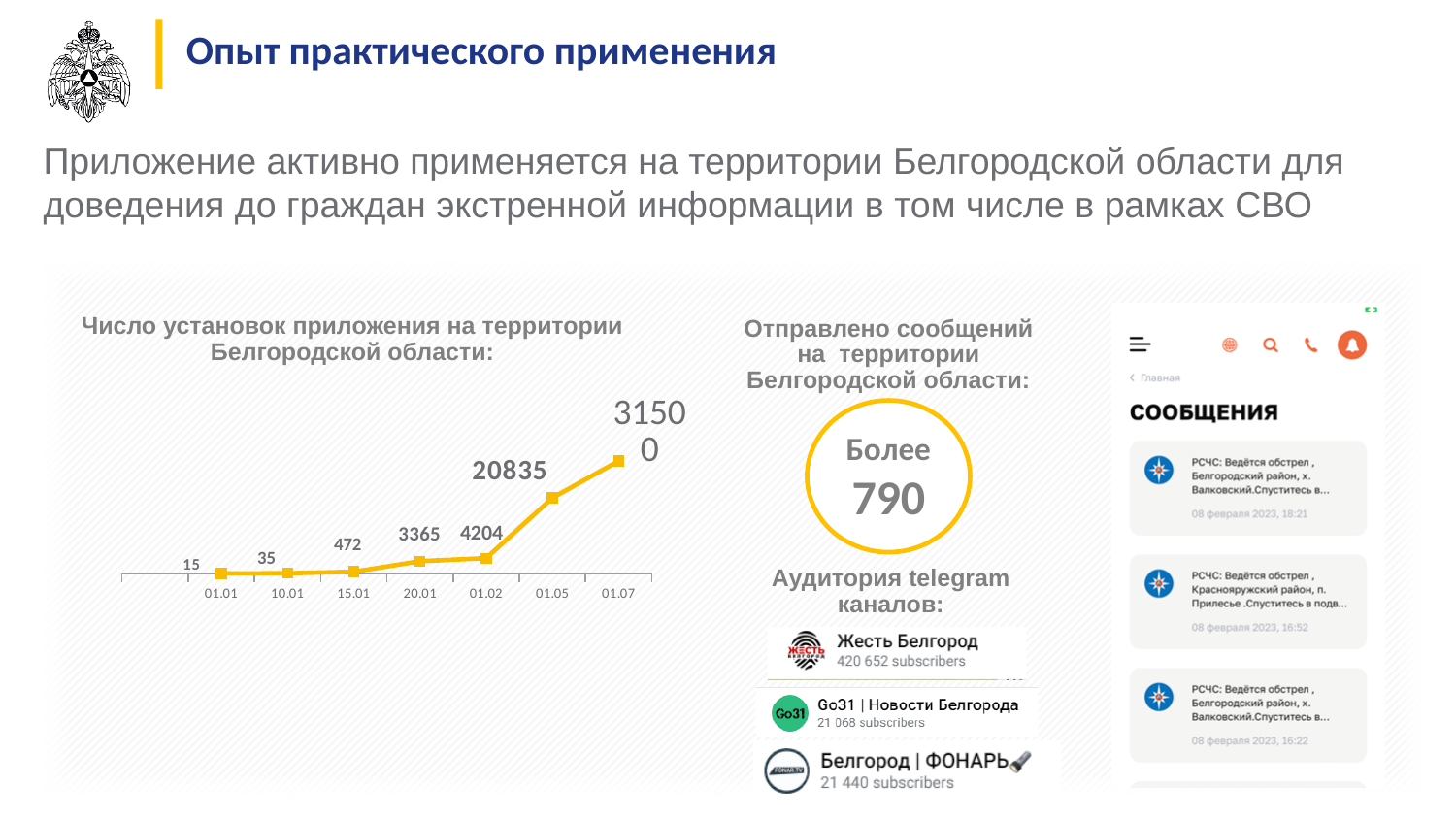
What is the number of app installations on 20.01? 3365 How many data points are plotted on the app installations line chart? 7 Do the values on the app installations line chart rise or fall from left to right? rise What is the title of the line chart on the slide? Число установок приложения на территории Белгородской области What is the number of app installations on 15.01? 472 What is the difference in app installations between 01.02 and 20.01? 839 What is the number of app installations on 01.01? 15 What is the number of app installations on 01.05? 20835 Which is larger on the line chart: the value for 10.01 or the value for 15.01? 15.01 What kind of chart is used to show the number of app installations in the Belgorod region? line chart Which date has the lowest number of app installations on the line chart? 01.01 Which date has the highest number of app installations on the line chart? 01.07